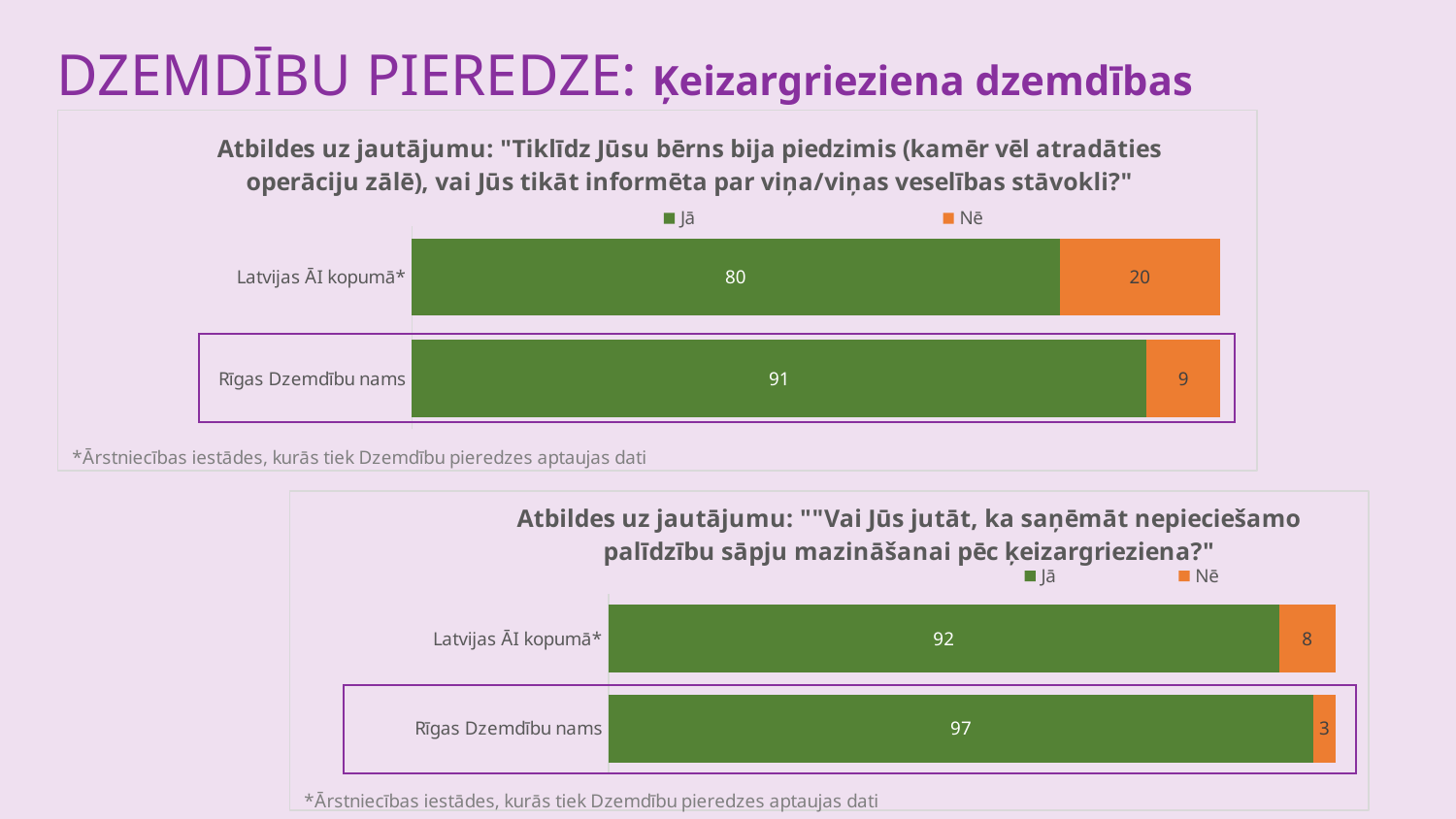
How many categories are shown in the top chart? 2 In the bottom chart, what is the 'Nē' value for Latvijas ĀI kopumā*? 8 In the bottom chart, what is the 'Jā' value for Rīgas Dzemdību nams? 97 In the top chart, what is the 'Jā' value for Latvijas ĀI kopumā*? 80 In the top chart, what is the difference between the 'Jā' values for Rīgas Dzemdību nams and Latvijas ĀI kopumā*? 11 What type of chart is the bottom chart? Stacked bar chart How many series does the legend of the bottom chart list? 2 In the top chart, what is the total of the stacked bar for Latvijas ĀI kopumā*? 100 In the top chart, which category has the higher 'Jā' value? Rīgas Dzemdību nams In the bottom chart, which category has the lower 'Nē' value? Rīgas Dzemdību nams In the bottom chart, what is the difference between the 'Nē' values for Latvijas ĀI kopumā* and Rīgas Dzemdību nams? 5 In the top chart, what is the 'Nē' value for Rīgas Dzemdību nams? 9